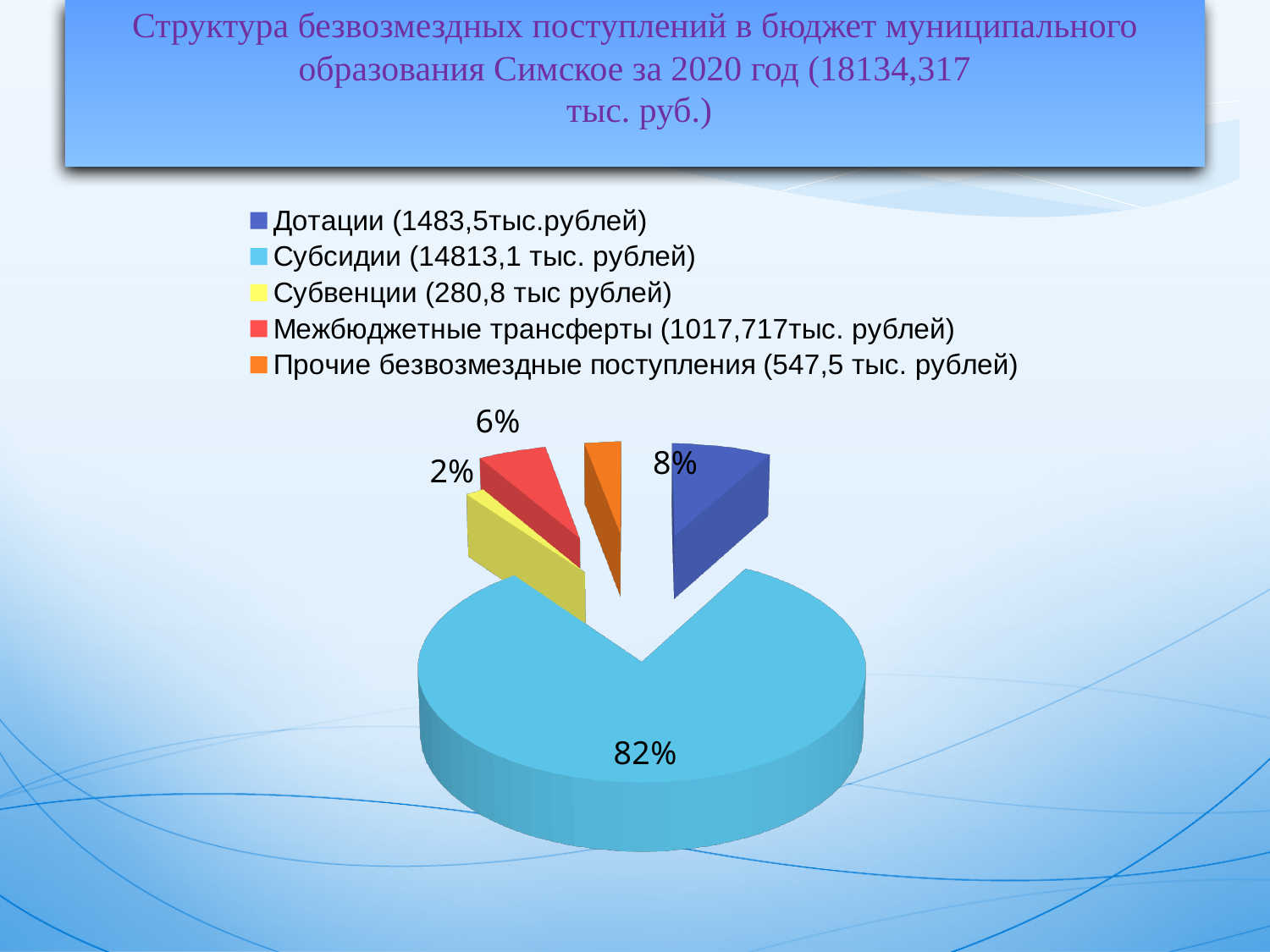
What is the difference in percentage points between the Субсидии slice and the Дотации slice? 74 What share of the pie does Дотации take? 8% Which category has the smallest slice of the pie? Субвенции How many categories does the legend of the pie chart list? 5 What share of the pie does Межбюджетные трансферты take? 6% What amount in тыс. рублей does the legend give for Прочие безвозмездные поступления? 547,5 Which is larger, the share for Дотации or the share for Межбюджетные трансферты? Дотации What kind of chart is shown on the slide? pie chart What share of the pie does Субсидии take? 82% What amount in тыс. рублей does the legend give for Дотации? 1483,5 Which category has the largest slice of the pie? Субсидии